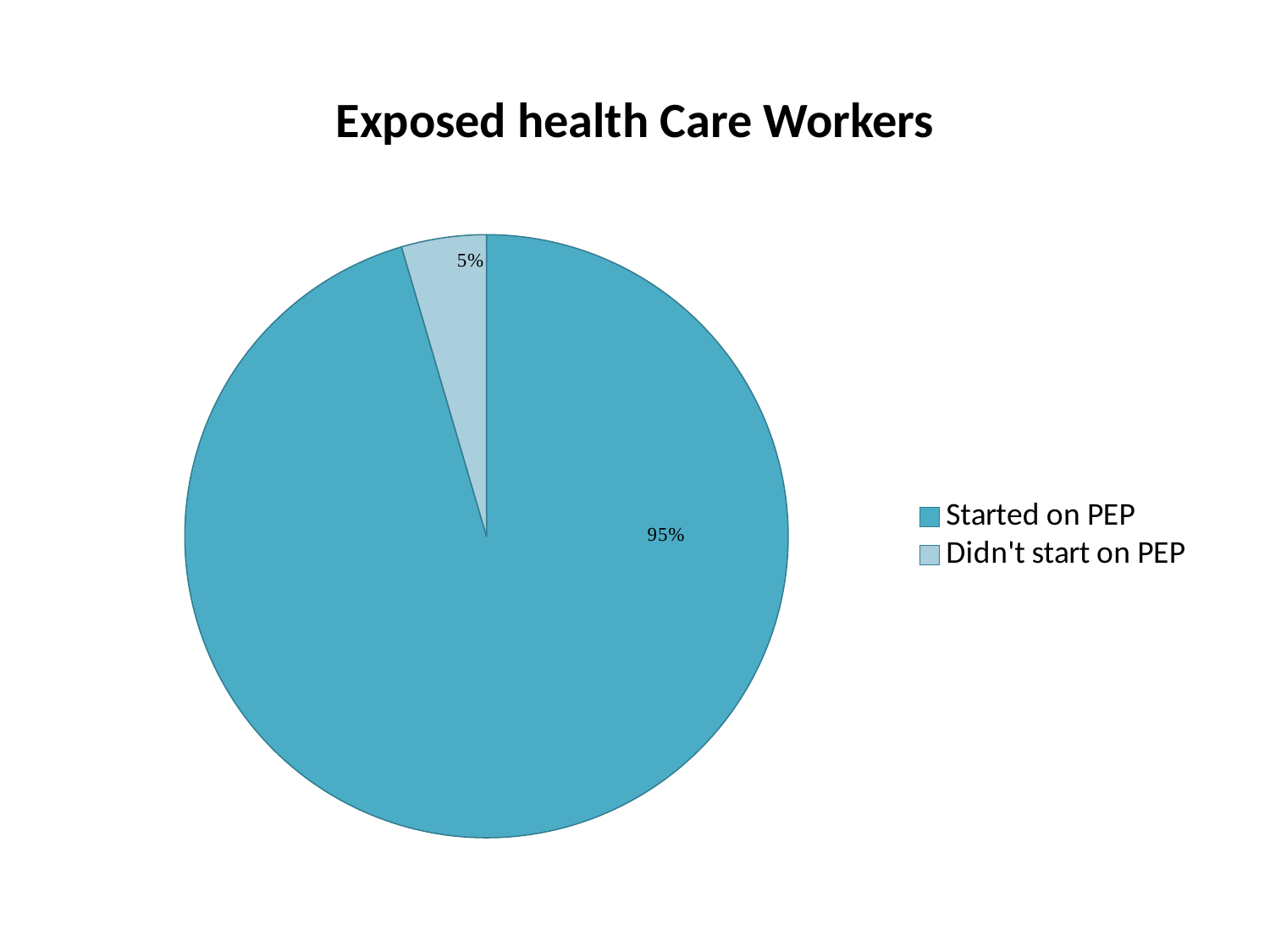
How many slices does the pie chart have? 2 Which category has the smallest share of the pie? Didn't start on PEP How many entries does the legend list? 2 What percentage of exposed health care workers didn't start on PEP? 5% Which is larger: the share for 'Started on PEP' or for 'Didn't start on PEP'? Started on PEP What is the difference in percentage points between the 'Started on PEP' and 'Didn't start on PEP' slices? 90 What share of the pie does the 'Didn't start on PEP' slice represent? 5% What is the title of the chart? Exposed health Care Workers Which category has the largest share of the pie? Started on PEP What kind of chart is shown on the slide? pie chart Which legend entry is shown in the lighter blue colour? Didn't start on PEP What percentage of exposed health care workers started on PEP? 95%